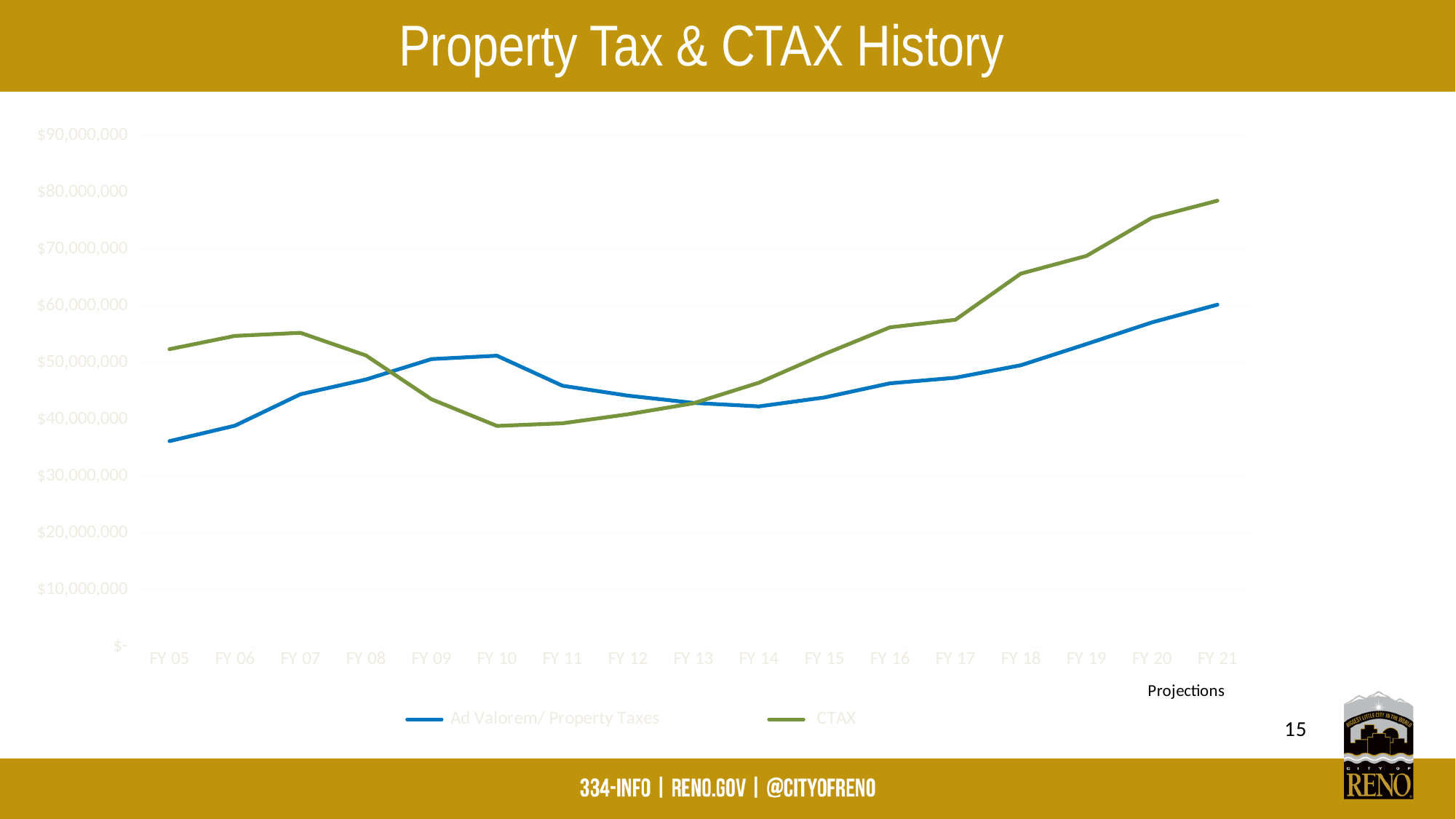
Does the CTAX series rise or fall from FY 10 to FY 21? Rise In which fiscal year does the CTAX series reach its highest value? FY 21 Is the CTAX value for FY 21 greater or less than $70,000,000? greater What kind of chart is shown on the slide? Line chart How many fiscal years are plotted along the x axis? 17 Is the CTAX value for FY 18 greater or less than $60,000,000? greater How many series does the legend list? 2 Is the Ad Valorem/ Property Taxes value for FY 05 greater or less than $40,000,000? less In which fiscal year is the Ad Valorem/ Property Taxes series at its lowest? FY 05 In FY 09, which series has the larger value, Ad Valorem/ Property Taxes or CTAX? Ad Valorem/ Property Taxes In which fiscal year is the CTAX series at its lowest? FY 10 What is the title of the chart? Property Tax & CTAX History